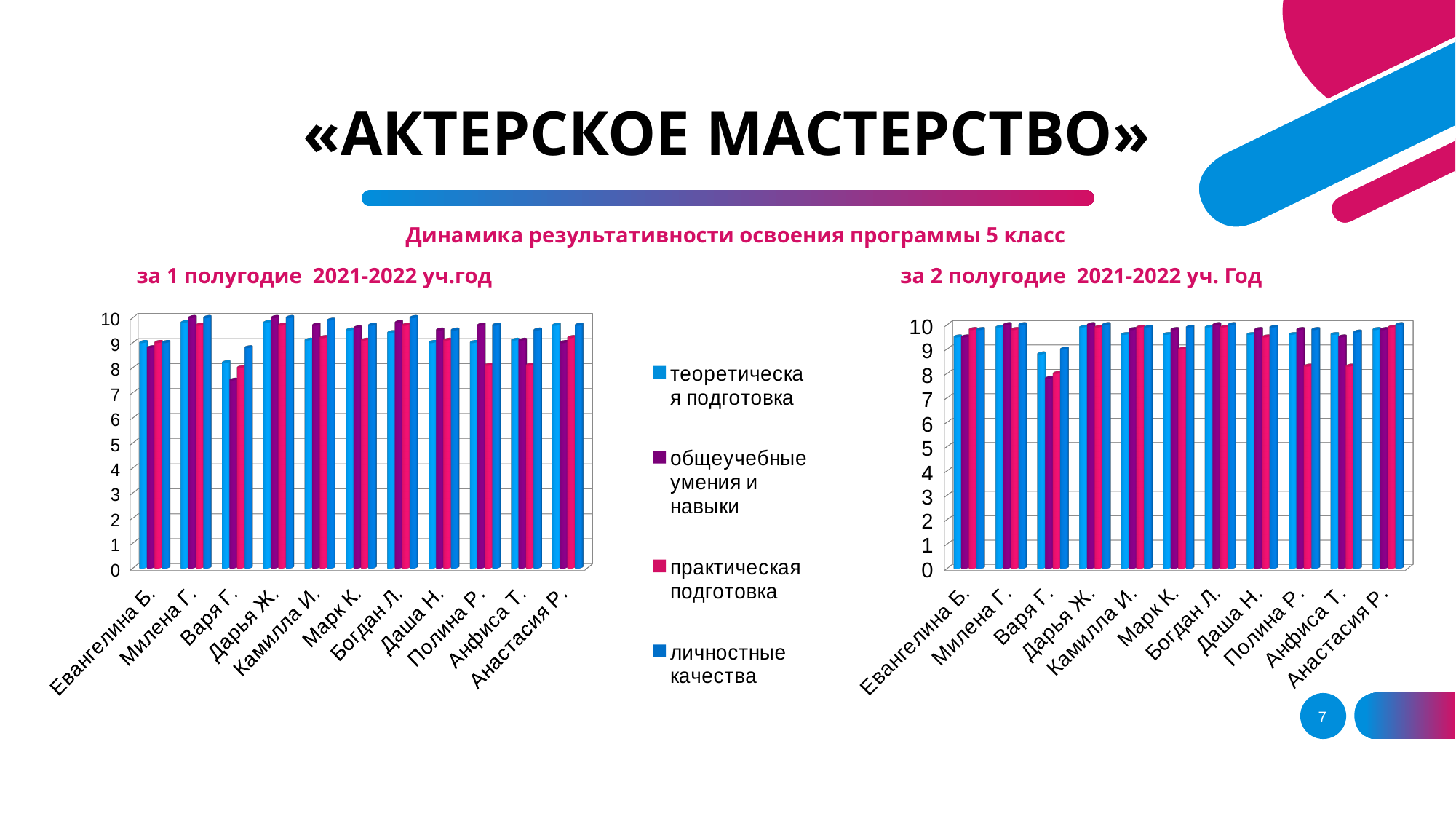
How many series does the legend list for the charts? 4 In the left chart (за 1 полугодие), is the value of практическая подготовка for Варя Г. greater or less than 9? less Which legend entry is shown in pink/magenta? практическая подготовка In the right chart (за 2 полугодие), which student has the lowest value for общеучебные умения и навыки? Варя Г. What is the subtitle shown above the two charts? Динамика результативности освоения программы 5 класс In the left chart (за 1 полугодие), is the value of практическая подготовка for Полина Р. greater or less than 9? less In the left chart (за 1 полугодие), which student has the lowest value for теоретическая подготовка? Варя Г. In the left chart (за 1 полугодие), which is larger: личностные качества for Милена Г. or for Варя Г.? Милена Г. What kind of chart is the left chart (за 1 полугодие 2021-2022 уч.год)? bar chart In the right chart (за 2 полугодие), is the value of личностные качества for Милена Г. greater or less than 9? greater How many students (categories) are shown on the x axis of the right chart (за 2 полугодие 2021-2022 уч. Год)? 11